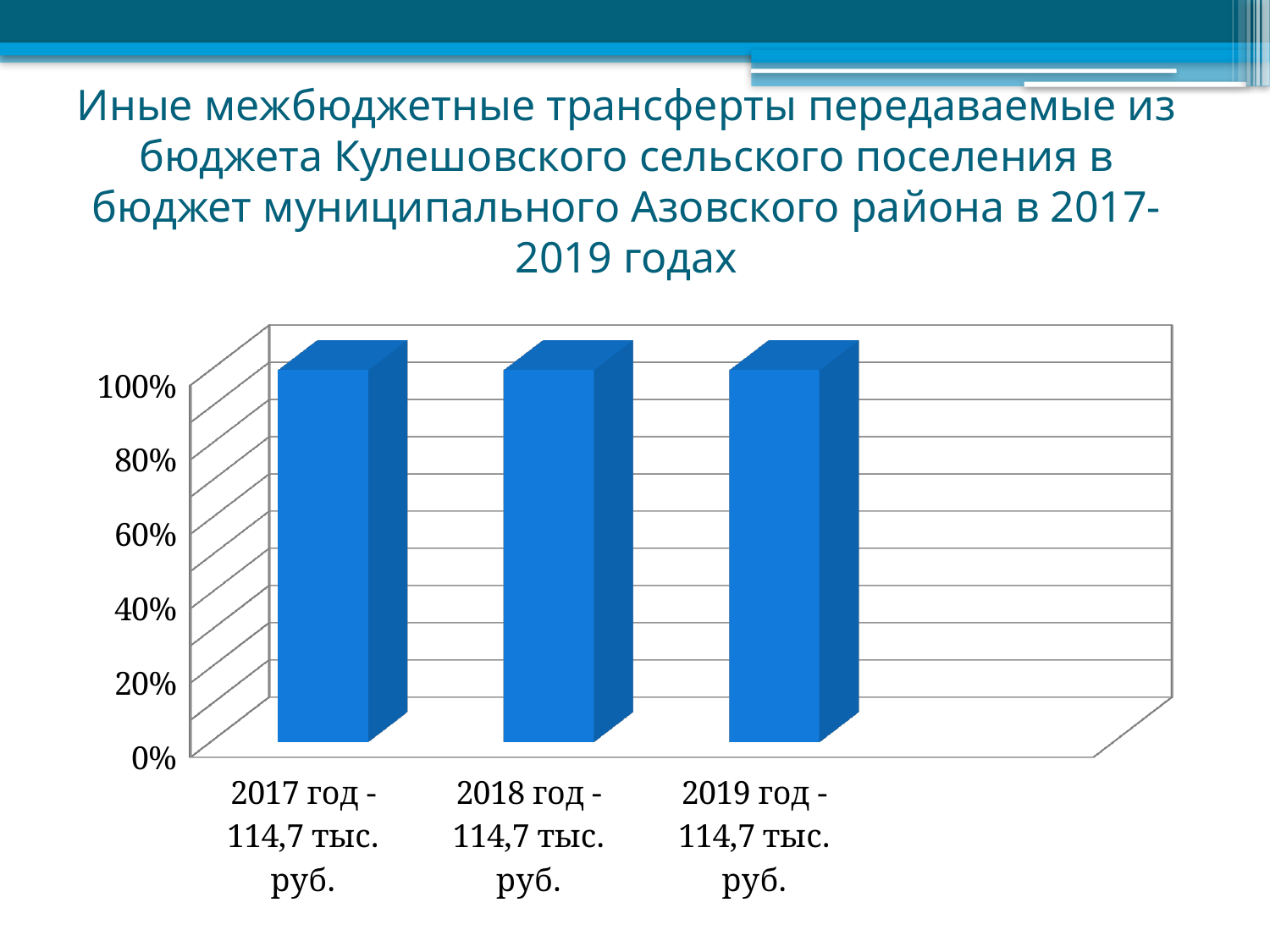
What kind of chart is shown on the slide? bar chart Is the bar for 2019 год greater or less than 60%? greater Is the bar for 2017 год greater or less than 80%? greater According to the category label, what amount is given for 2019 год? 114,7 тыс. руб. According to the category label, what amount is given for 2017 год? 114,7 тыс. руб. What is the highest percentage tick shown on the vertical axis? 100% What colour are the bars in the chart? blue Which years are covered by the chart's categories? 2017, 2018, 2019 How many bars (categories) does the chart show? 3 Do the bar heights rise, fall, or stay the same from 2017 to 2019? stay the same According to the category label, what amount is given for 2018 год? 114,7 тыс. руб. Is the amount for 2018 год larger than, smaller than, or equal to the amount for 2019 год? equal